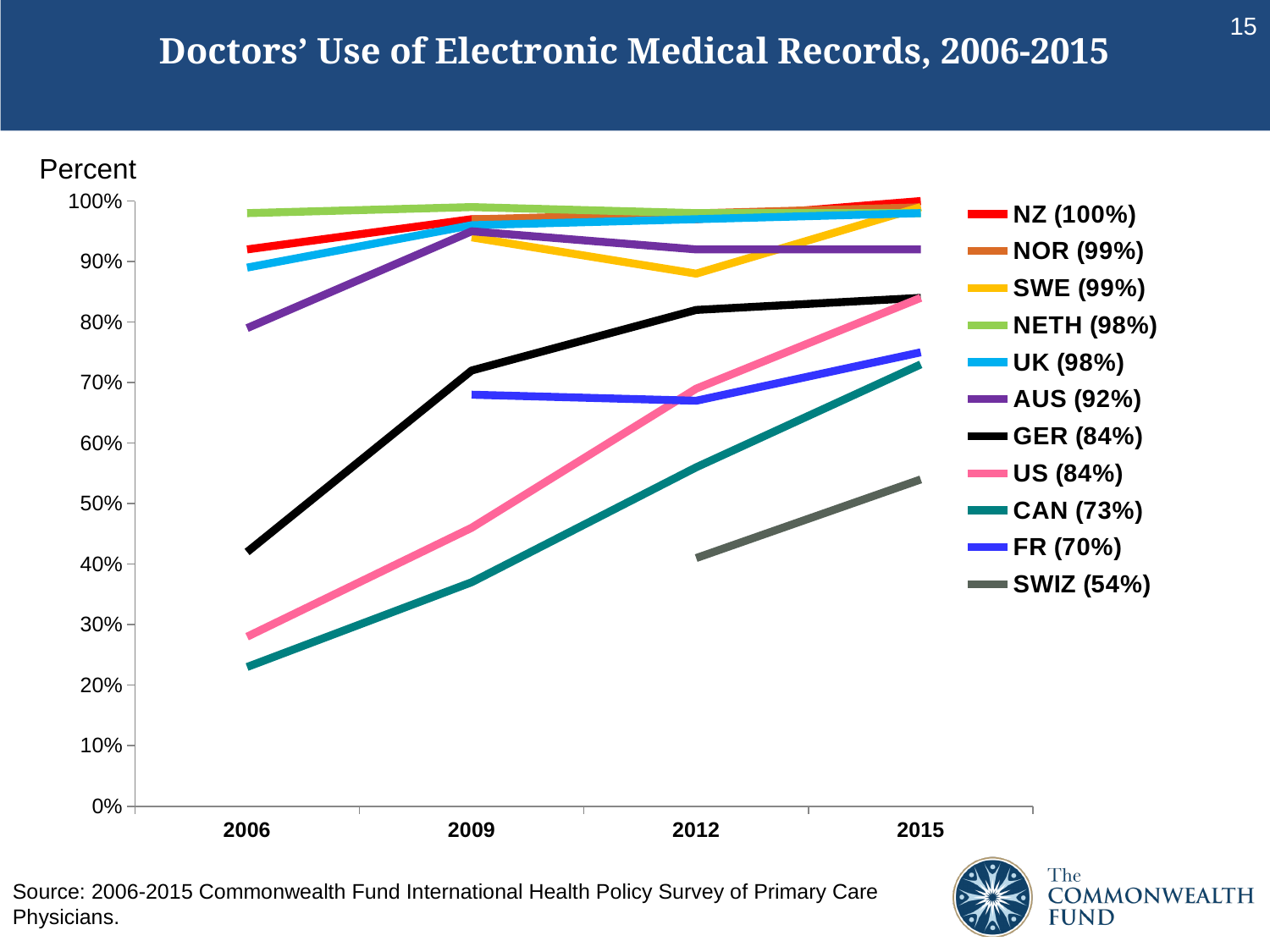
According to the legend, what is the value for SWIZ in 2015? 54% According to the legend, what is the value for NZ in 2015? 100% Does the value for CAN rise or fall from 2006 to 2015? rise What type of chart is shown on the slide? line chart In 2015, which is larger, the value for AUS or the value for FR? AUS Is the value for GER in 2006 greater or less than 50%? less According to the legend, what is the value for CAN in 2015? 73% What is the difference between the 2015 values for GER and CAN? 11 percentage points Which country has the highest value in 2015? NZ Which country has the lowest value in 2015? SWIZ How many years are shown on the x axis? 4 How many series does the legend list? 11